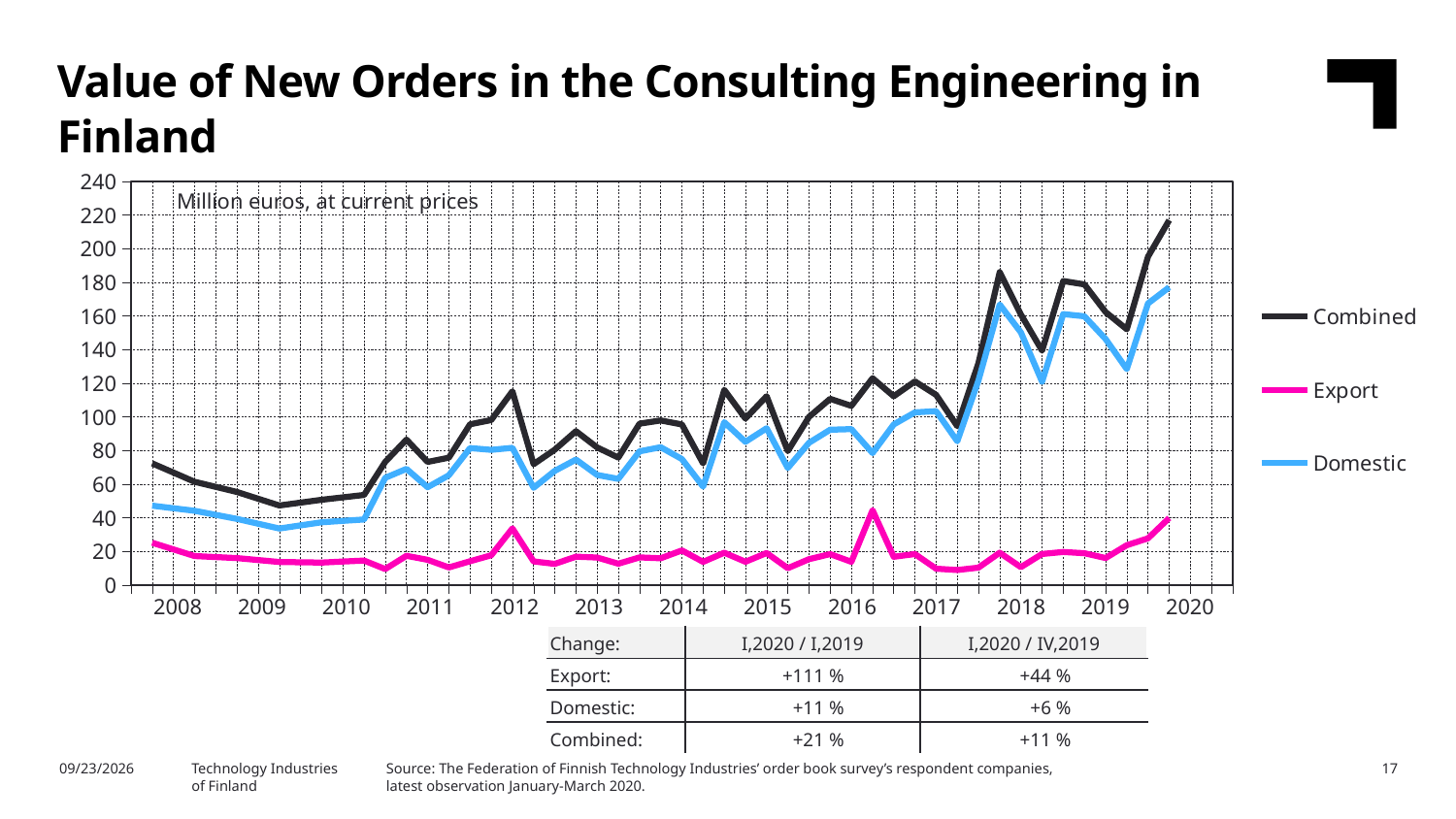
How many year labels are shown on the x axis? 13 Which series has the lowest values across the whole chart? Export Is the value for Export at the start of 2008 greater or less than 40? less What are the three series named in the legend? Combined, Export, Domestic Is the value for Combined at the start of 2009 greater or less than 80? less Which series has the highest values across the whole chart? Combined Is the latest (2020) value for Domestic greater or less than 160? greater Does the Combined series rise or fall overall from 2017 to 2020? rise How many series does the legend list? 3 What unit is stated inside the chart area for the values? Million euros, at current prices What kind of chart is shown on the slide? line chart